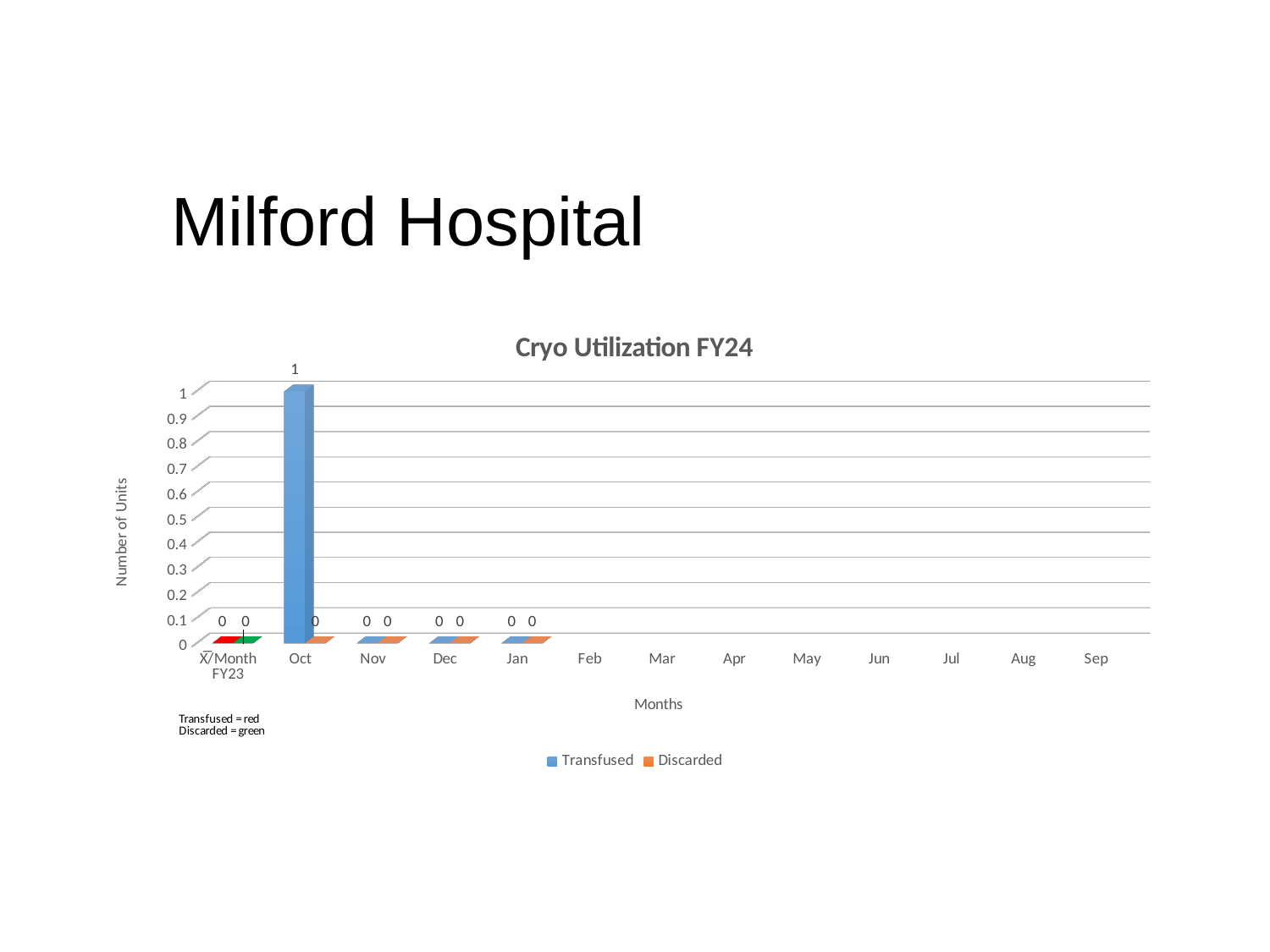
How many series does the chart legend list? 2 What is the Discarded value for Jan? 0 What is the difference between the Transfused and Discarded values for Oct? 1 What are the two series named in the legend? Transfused and Discarded What type of chart is shown on the slide? bar chart Which month has the highest Transfused value? Oct Which is larger, the Transfused value for Oct or the Transfused value for Dec? Transfused value for Oct What is the Transfused value for Oct? 1 What is the Transfused value for Nov? 0 What is the title of the chart? Cryo Utilization FY24 What is the Discarded value for Oct? 0 How many month categories are shown on the x axis? 13